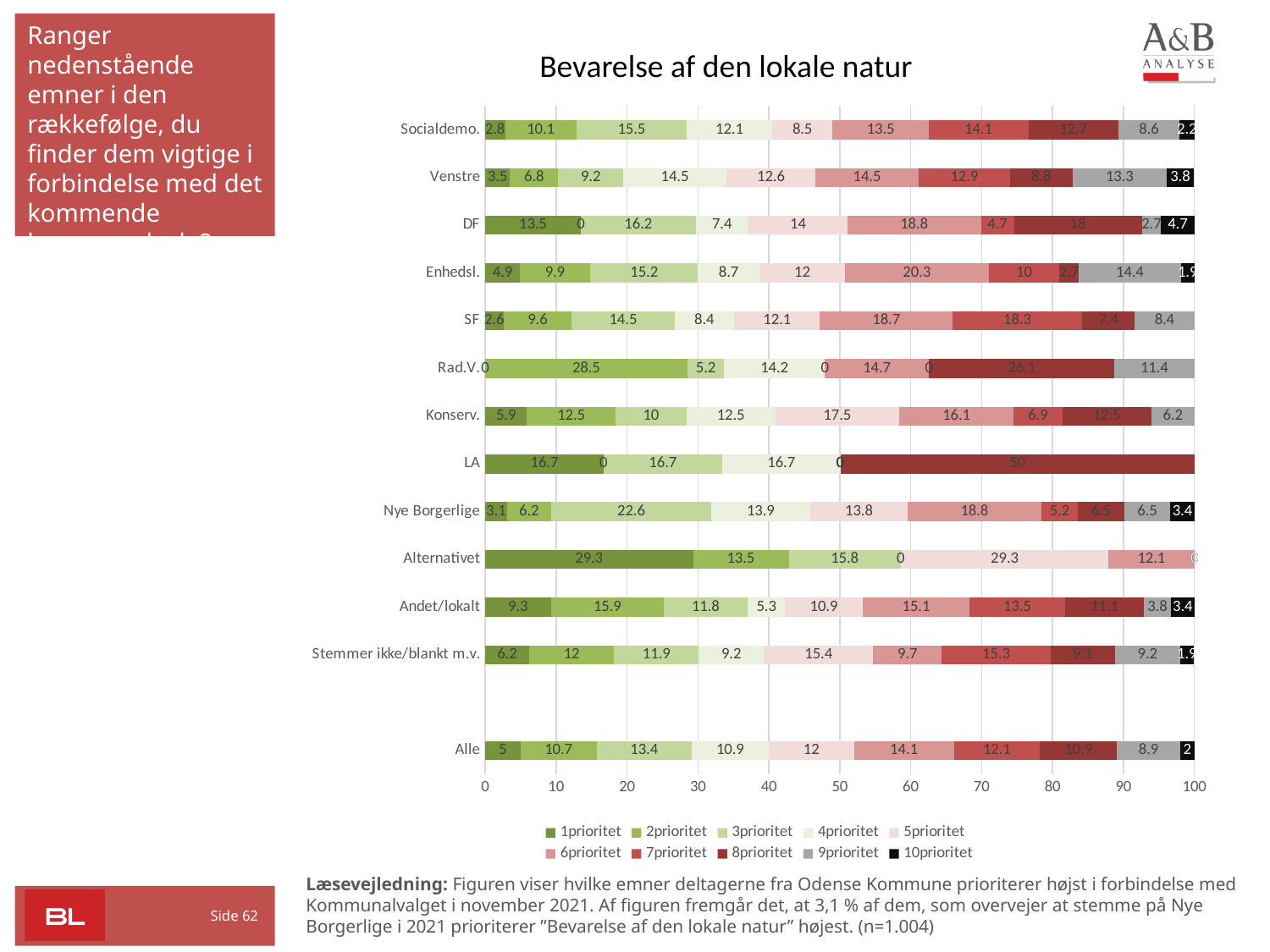
How many categories (rows) are plotted on the chart? 13 What is the 8prioritet value for LA? 50 What is the 2prioritet value for Rad.V.? 28.5 For Alle, which is larger: the 2prioritet value or the 3prioritet value? 3prioritet What kind of chart is shown on the slide? Stacked bar chart What is the difference between the 3prioritet value (15.5) and the 2prioritet value (10.1) for Socialdemo.? 5.4 What is the 1prioritet value for Alle? 5 Which category has the highest 1prioritet value? Alternativet What is the 10prioritet value for DF? 4.7 How many series does the legend list? 10 What is the title of the chart? Bevarelse af den lokale natur What is the 1prioritet value for Alternativet? 29.3